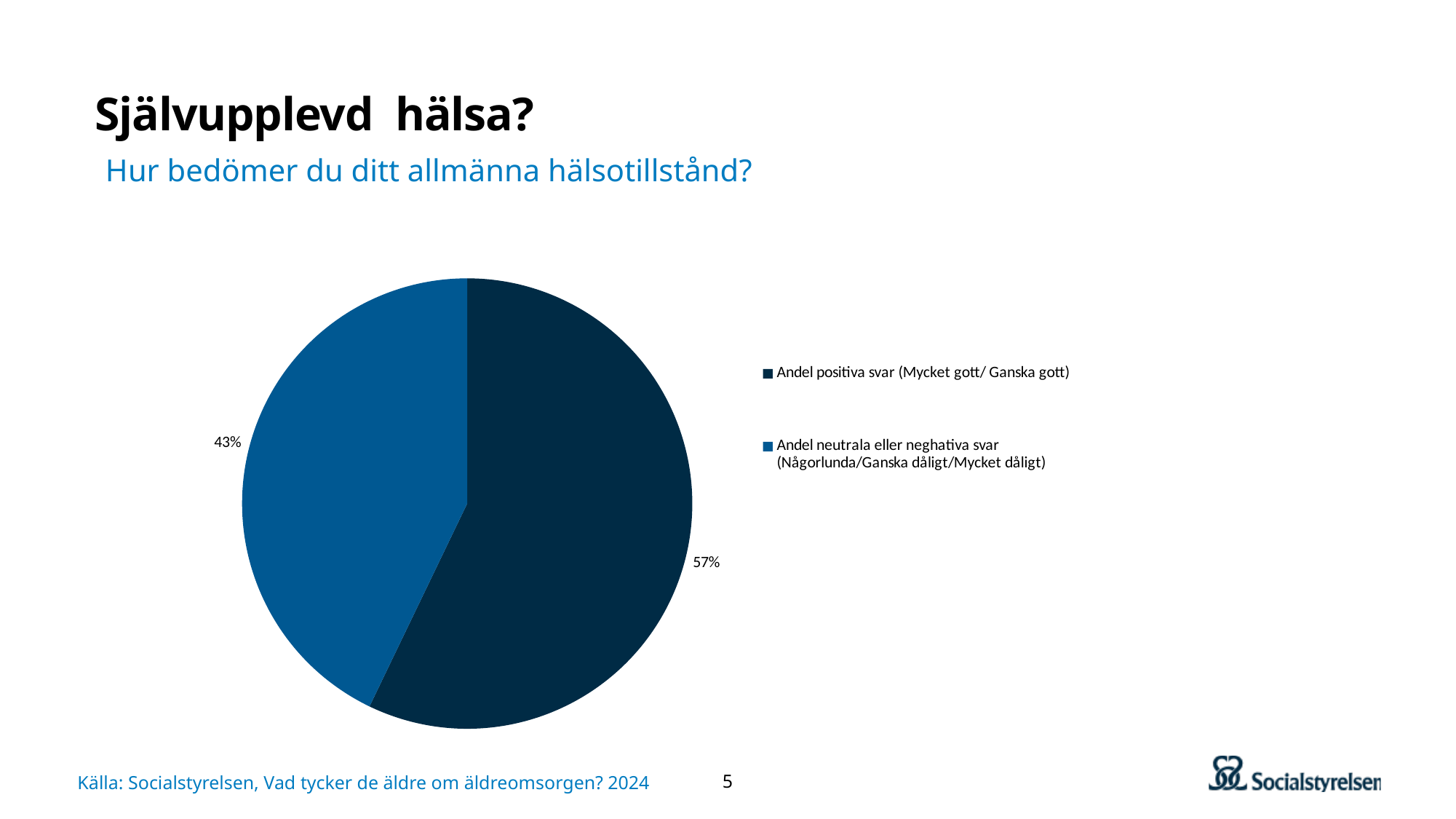
What is the total of the two slice percentages shown on the pie? 100% What question is the chart based on, as shown in the blue subtitle? Hur bedömer du ditt allmänna hälsotillstånd? What share of the pie is labelled 'Andel neutrala eller neghativa svar (Någorlunda/Ganska dåligt/Mycket dåligt)'? 43% Which colour represents 'Andel positiva svar (Mycket gott/ Ganska gott)' in the pie chart? dark navy blue Which slice of the pie is the largest? Andel positiva svar (Mycket gott/ Ganska gott) How many entries does the legend list? 2 What is the difference in percentage points between the positive slice and the neutral/negative slice? 14 How many slices does the pie chart have? 2 What kind of chart is shown on the slide? pie chart Which slice of the pie is the smallest? Andel neutrala eller neghativa svar (Någorlunda/Ganska dåligt/Mycket dåligt) What share of the pie is labelled 'Andel positiva svar (Mycket gott/ Ganska gott)'? 57% Which is larger: the share of positive answers or the share of neutral/negative answers? Andel positiva svar (Mycket gott/ Ganska gott)